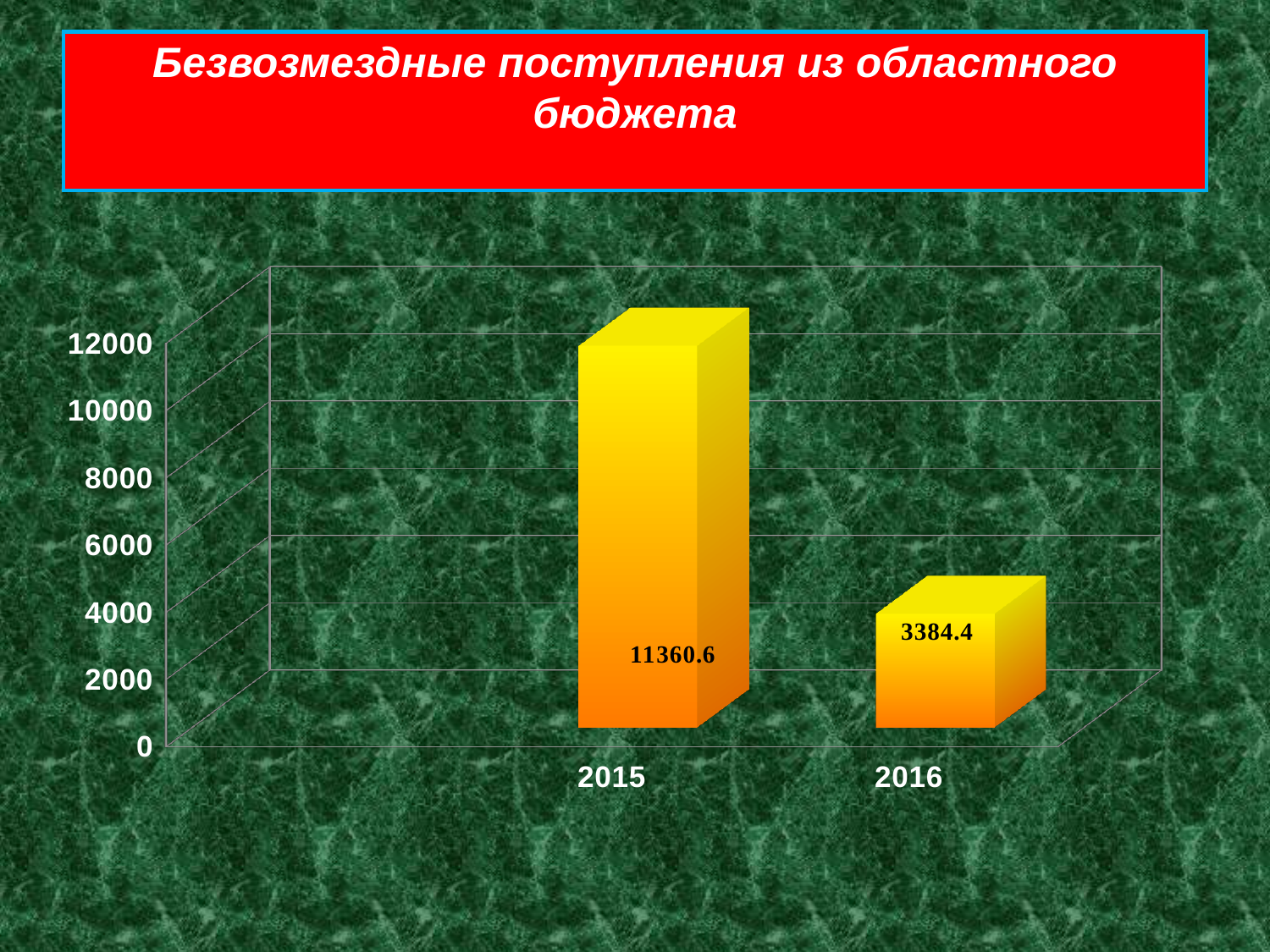
What is the title of the slide? Безвозмездные поступления из областного бюджета What is the value for 2015? 11360.6 What kind of chart is shown on the slide? bar chart Which is larger, the value for 2015 or the value for 2016? 2015 What is the value for 2016? 3384.4 Is the value for 2015 greater or less than 10000? greater What is the difference between the values for 2015 and 2016? 7976.2 Which year has the lowest value? 2016 Which year has the highest value? 2015 How many categories are shown on the x axis? 2 Is the value for 2016 greater or less than 4000? less Do the values rise or fall from 2015 to 2016? fall